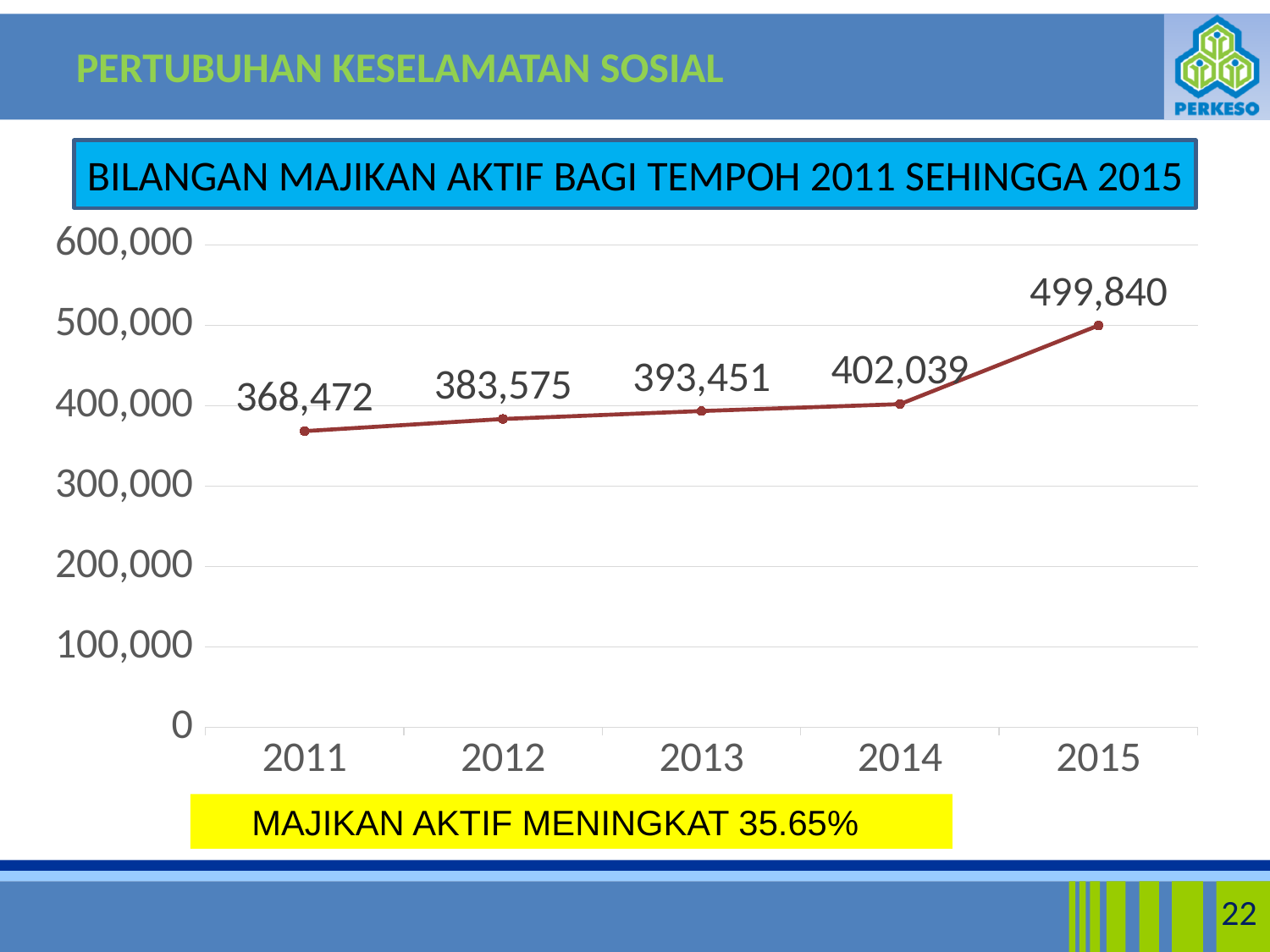
Which year has the highest value? 2015 How many years are plotted on the chart? 5 What is the difference between the values for 2012 and 2011? 15,103 What is the value for 2015? 499,840 What is the value for 2011? 368,472 What is the difference between the values for 2015 and 2014? 97,801 What is the value for 2013? 393,451 What kind of chart is shown on the slide? line chart Which year has the lowest value? 2011 Which is larger, the value for 2013 or the value for 2014? 2014 Do the values rise or fall from 2011 to 2015? rise Is the value for 2015 greater or less than 400,000? greater